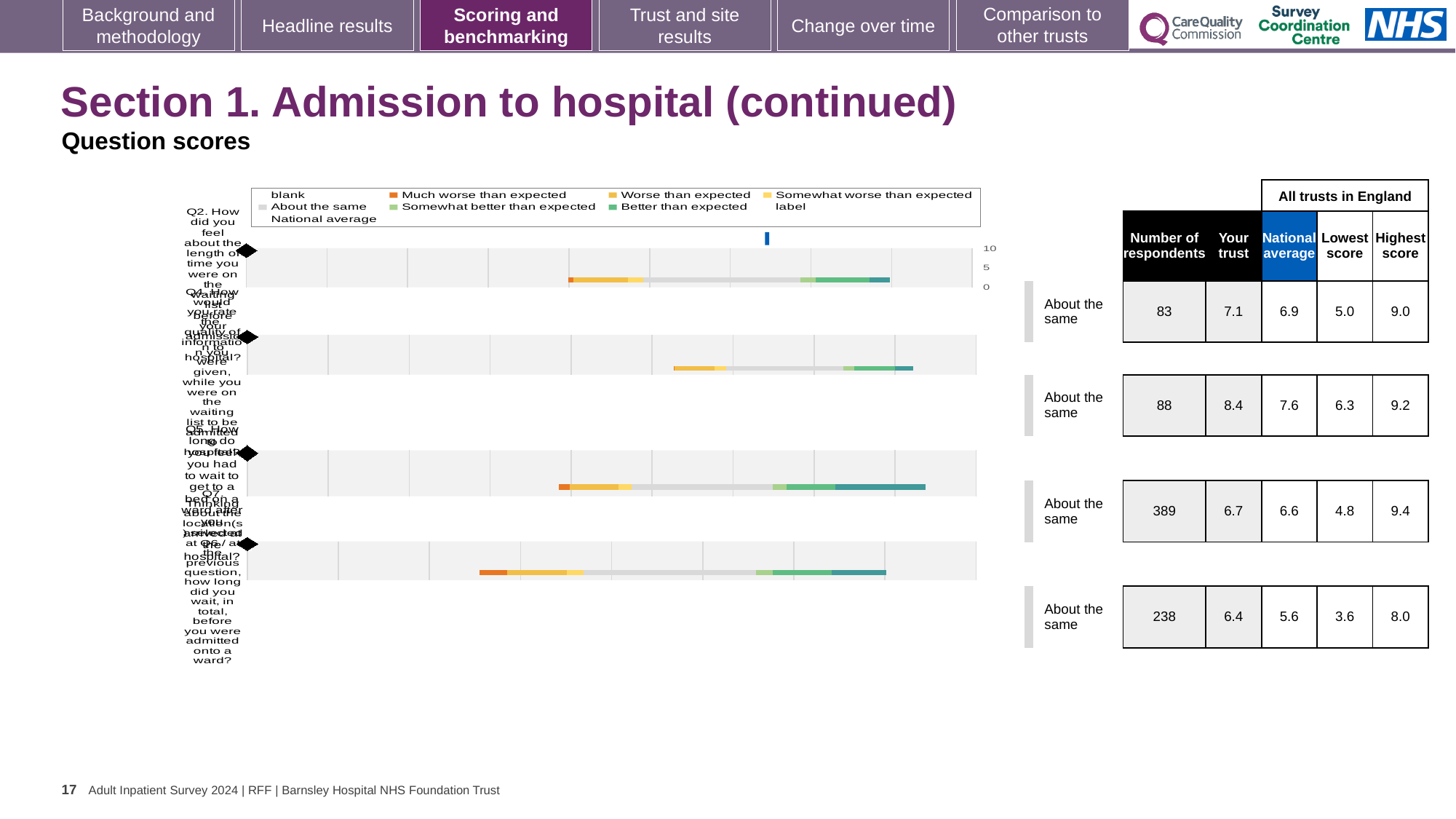
How many question rows (bars) are plotted in the chart? 4 What is the national average for the third question row (Q5)? 6.6 What is the difference between the trust score and the national average for the fourth question row (Q7)? 0.8 What is the 'Your trust' score for the second question row (Q4)? 8.4 What kind of chart is shown on the slide? bar chart Is the trust score for the second question row (Q4) larger than its national average? yes, 8.4 vs 7.6 What benchmark category is shown for every question row in the chart? About the same What is the highest score across all trusts in England for the fourth question row (Q7)? 8.0 Which question row has the lowest 'Your trust' score? the fourth row (Q7), 6.4 What is the number of respondents for the first question row (Q2)? 83 Which colour does the legend use for 'Much worse than expected'? dark orange Which question row has the highest number of respondents? the third row (Q5), 389